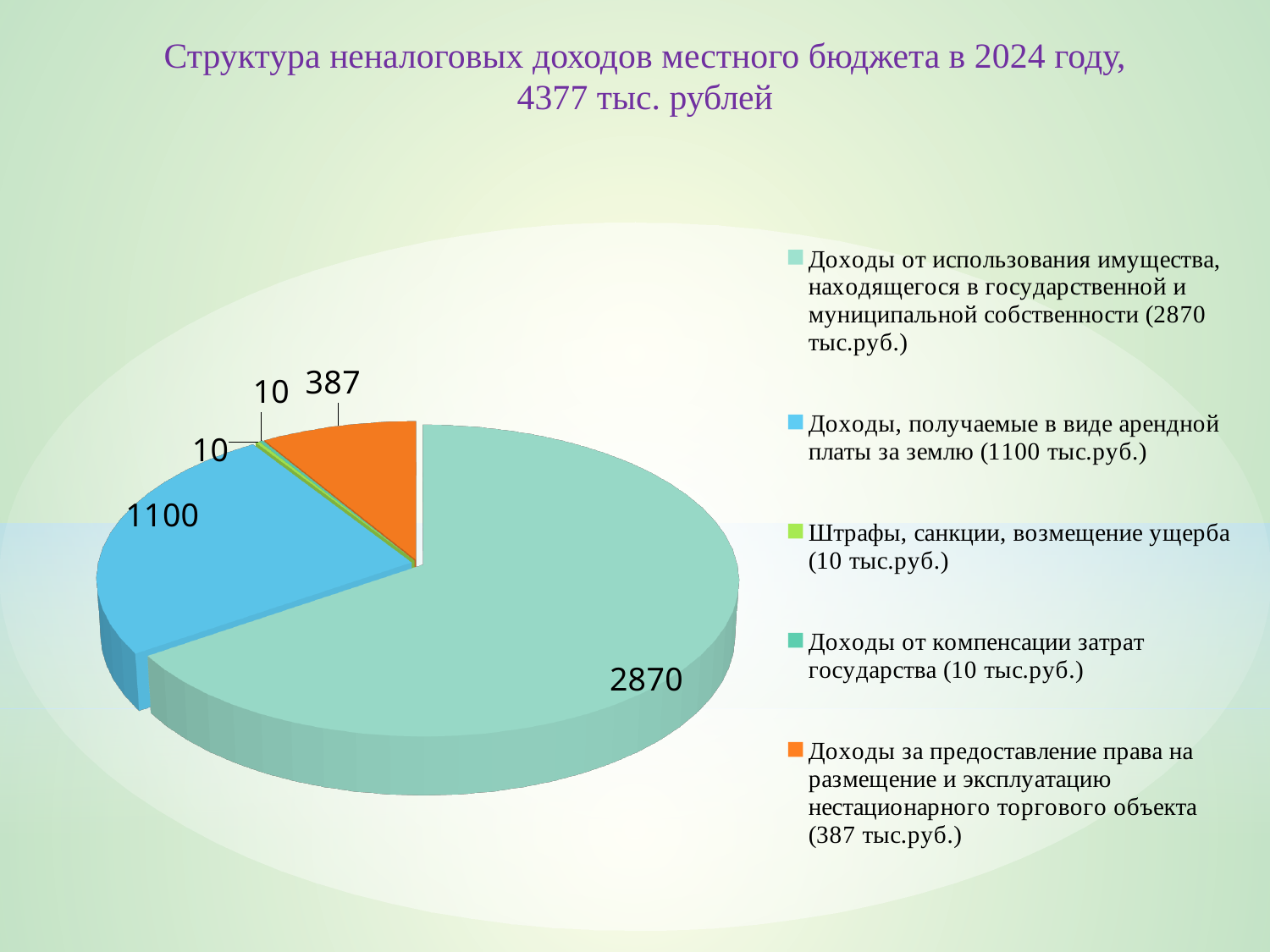
What is the value for "Штрафы, санкции, возмещение ущерба"? 10 What is the total of all slices in the pie chart, as stated in the title? 4377 тыс. рублей How many slices does the pie chart have? 5 What is the value for "Доходы за предоставление права на размещение и эксплуатацию нестационарного торгового объекта"? 387 What is the value for "Доходы, получаемые в виде арендной платы за землю"? 1100 How many entries does the legend list? 5 What is the difference between the largest slice (2870) and the slice for rental payments for land (1100)? 1770 What is the difference between the value for rental payments for land and the value for placement of non-stationary trade objects? 713 Which is larger: the value for "Доходы, получаемые в виде арендной платы за землю" or the value for "Доходы за предоставление права на размещение и эксплуатацию нестационарного торгового объекта"? Доходы, получаемые в виде арендной платы за землю What share of the total (4377) does the slice with value 2870 represent, to one decimal place? 65.6% What kind of chart is shown on the slide? pie chart Which category has the largest slice of the pie? Доходы от использования имущества, находящегося в государственной и муниципальной собственности